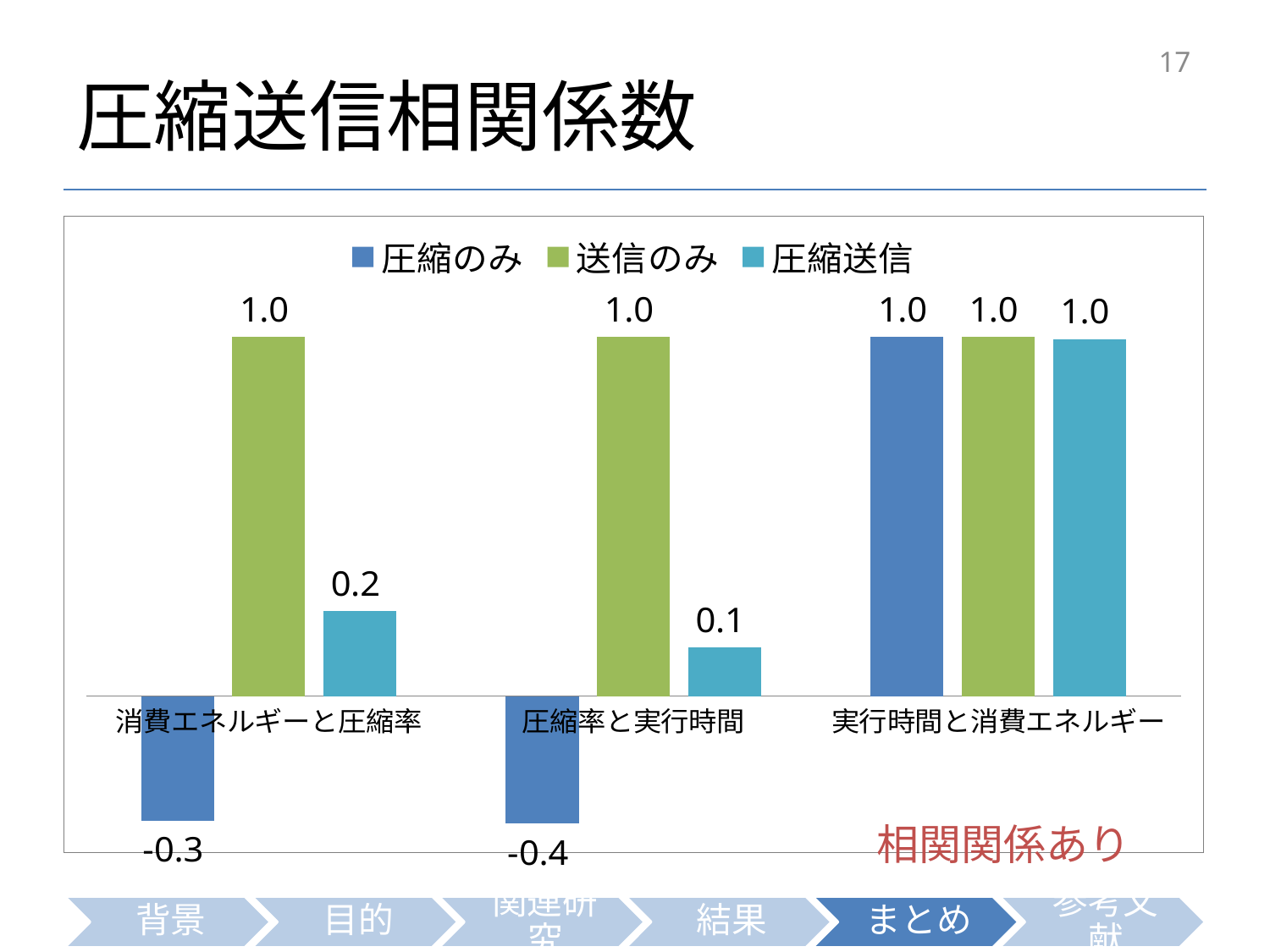
What is the value of 送信のみ for 実行時間と消費エネルギー? 1.0 What kind of chart is shown on the slide? bar chart How many categories are shown on the x axis? 3 Which category has the lowest value for the 圧縮のみ series? 圧縮率と実行時間 What is the value of 圧縮送信 for 圧縮率と実行時間? 0.1 What is the value of 圧縮のみ for 圧縮率と実行時間? -0.4 Which is larger for 圧縮率と実行時間: the 圧縮送信 value or the 圧縮のみ value? 圧縮送信 What is the value of 圧縮送信 for 消費エネルギーと圧縮率? 0.2 What is the value of 圧縮のみ for 消費エネルギーと圧縮率? -0.3 What is the difference between the 送信のみ value and the 圧縮送信 value for 消費エネルギーと圧縮率? 0.8 Which category has the highest value for the 圧縮送信 series? 実行時間と消費エネルギー How many series does the legend list? 3